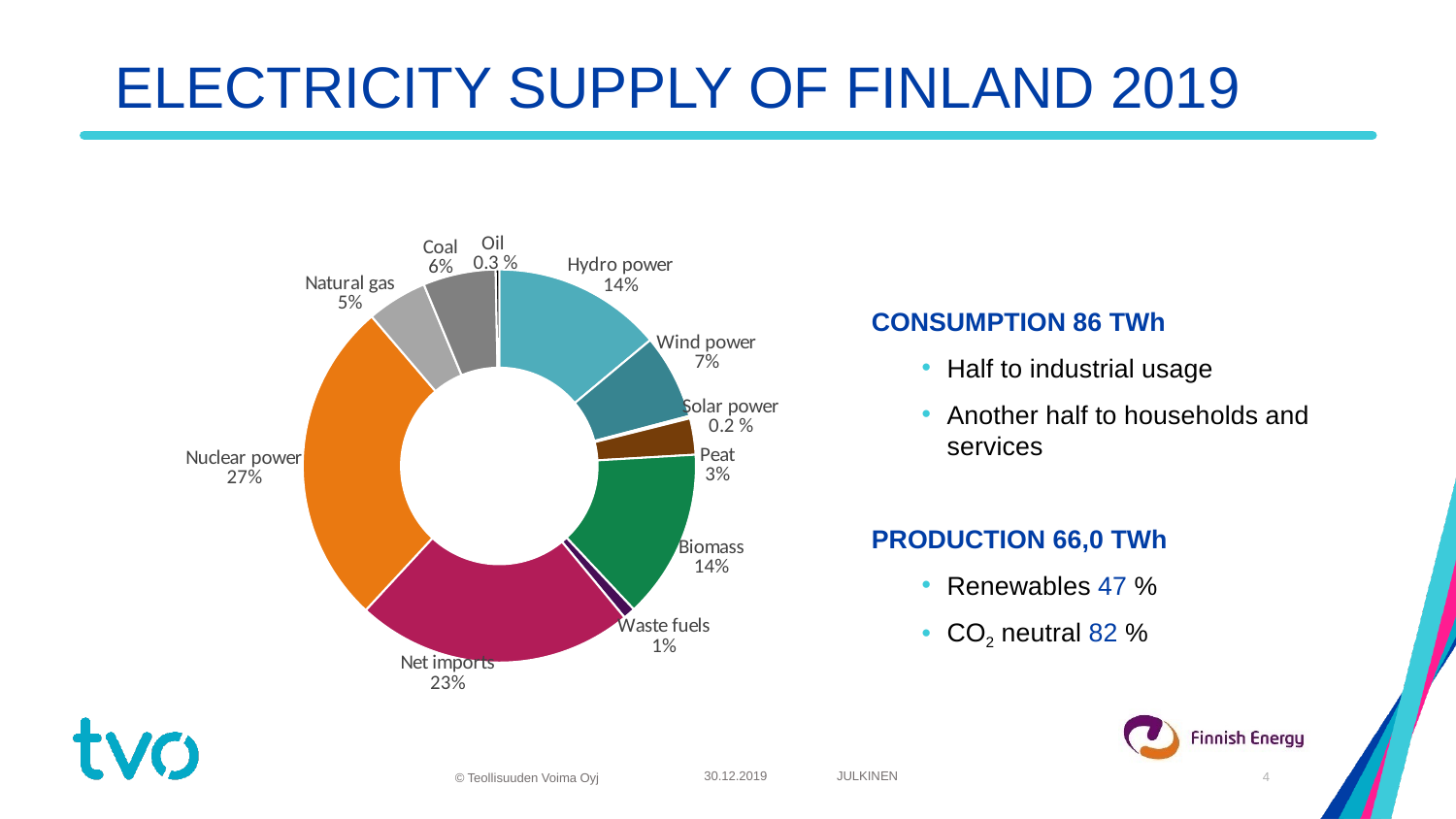
What kind of chart is used to show the electricity supply? Doughnut (pie) chart How many sources are shown in the chart? 11 Which source has the largest share of the electricity supply? Nuclear power What is the difference in percentage points between nuclear power and net imports? 4 What percentage of the electricity supply comes from solar power? 0.2 % What share of Finland's electricity supply in 2019 comes from nuclear power? 27% What is the share of peat in the electricity supply? 3% Which source has the smallest share of the electricity supply? Solar power What is the combined share of hydro power and biomass? 28% Which has a larger share, wind power or coal? Wind power What is the share of oil in the electricity supply? 0.3 % What share of the electricity supply is net imports? 23%